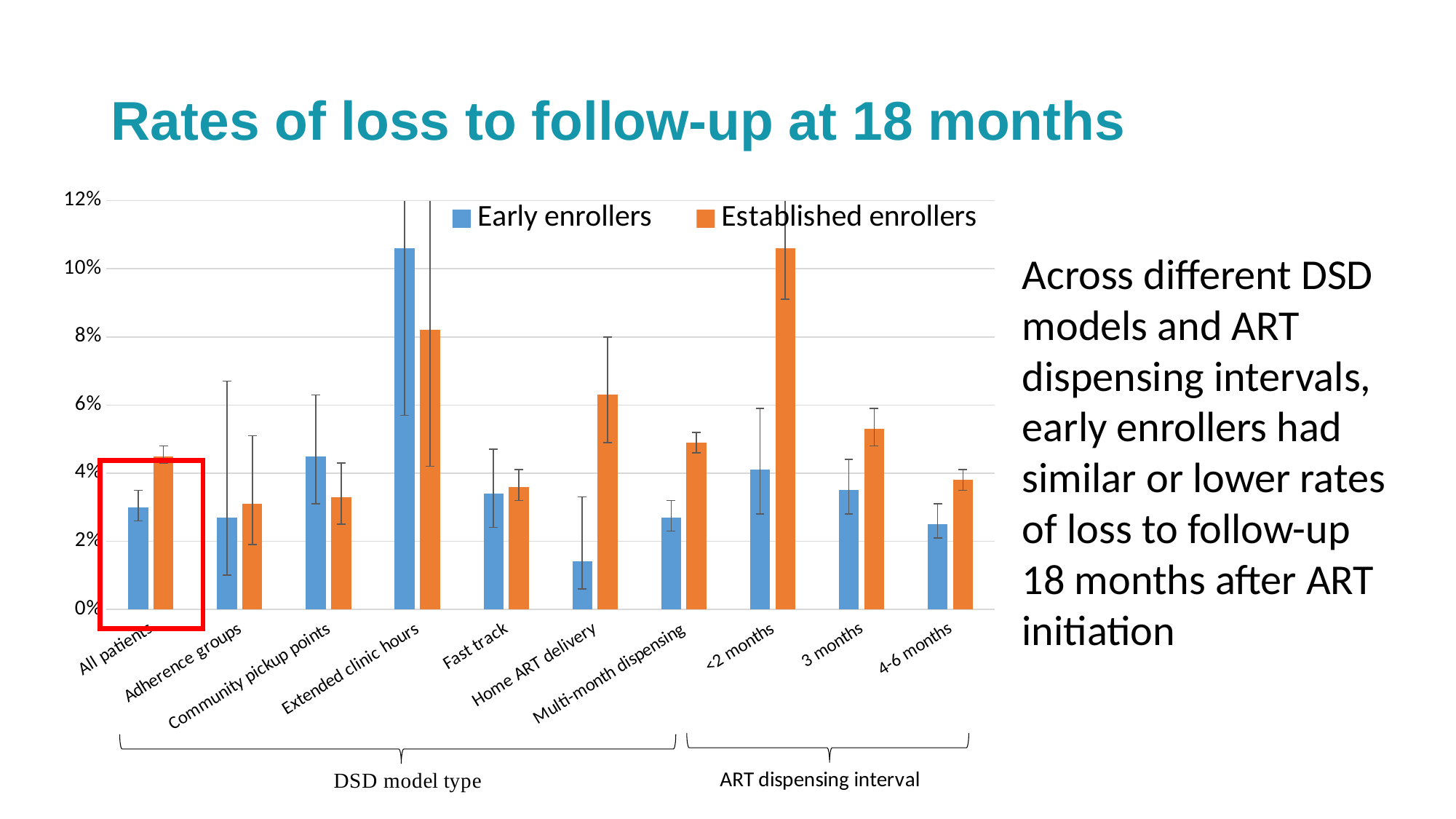
Is the Early enrollers value for Extended clinic hours greater or less than 10%? greater Is the Early enrollers value for Home ART delivery greater or less than 2%? less What is the title of the chart? Rates of loss to follow-up at 18 months Which category has the highest value for Early enrollers? Extended clinic hours For Extended clinic hours, which series has the larger value, Early enrollers or Established enrollers? Early enrollers What kind of chart is shown on the slide? bar chart How many categories are shown on the x axis? 10 For All patients, which series has the larger value, Early enrollers or Established enrollers? Established enrollers Which category has the lowest value for Early enrollers? Home ART delivery Which category has the highest value for Established enrollers? <2 months Is the Established enrollers value for Multi-month dispensing greater or less than 4%? greater How many series does the legend list? 2